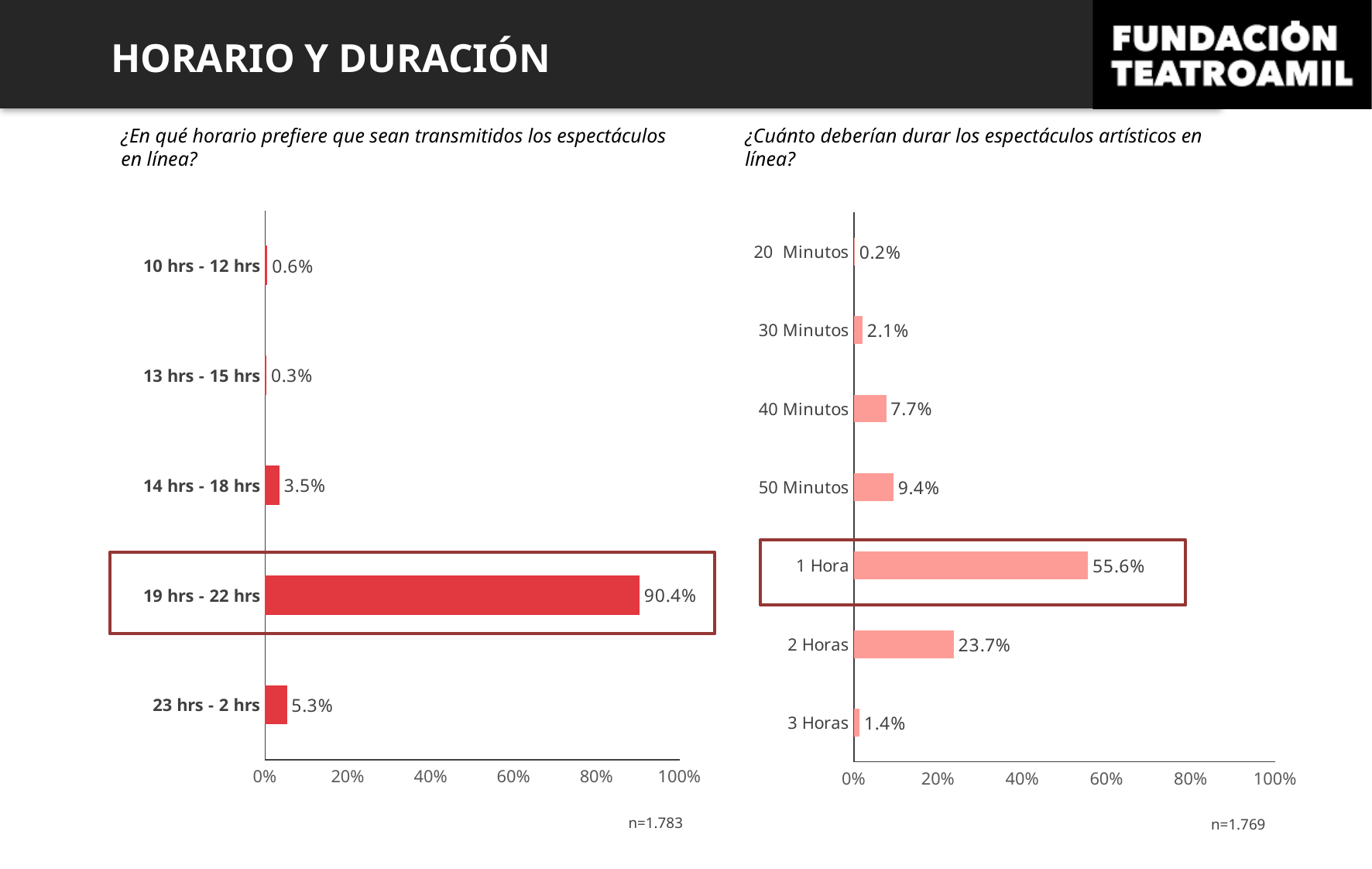
In the left chart (preferred broadcast time), what is the value for 19 hrs - 22 hrs? 90.4% In the right chart (preferred duration), what is the value for 2 Horas? 23.7% In the right chart (preferred duration), which duration has the highest value? 1 Hora In the left chart (preferred broadcast time), which time slot has the lowest value? 13 hrs - 15 hrs What type of chart is the left chart (preferred broadcast time)? Bar chart In the right chart (preferred duration), what is the difference between the values for 1 Hora and 2 Horas? 31.9% In the left chart (preferred broadcast time), how many time slots are shown? 5 In the right chart (preferred duration), which is larger, the value for 40 Minutos or 50 Minutos? 50 Minutos In the left chart (preferred broadcast time), what is the difference between the values for 23 hrs - 2 hrs and 14 hrs - 18 hrs? 1.8% In the right chart (preferred duration), which duration has the lowest value? 20 Minutos In the right chart (preferred duration), how many duration categories are shown? 7 In the left chart (preferred broadcast time), is the value for 19 hrs - 22 hrs greater or less than 80%? greater